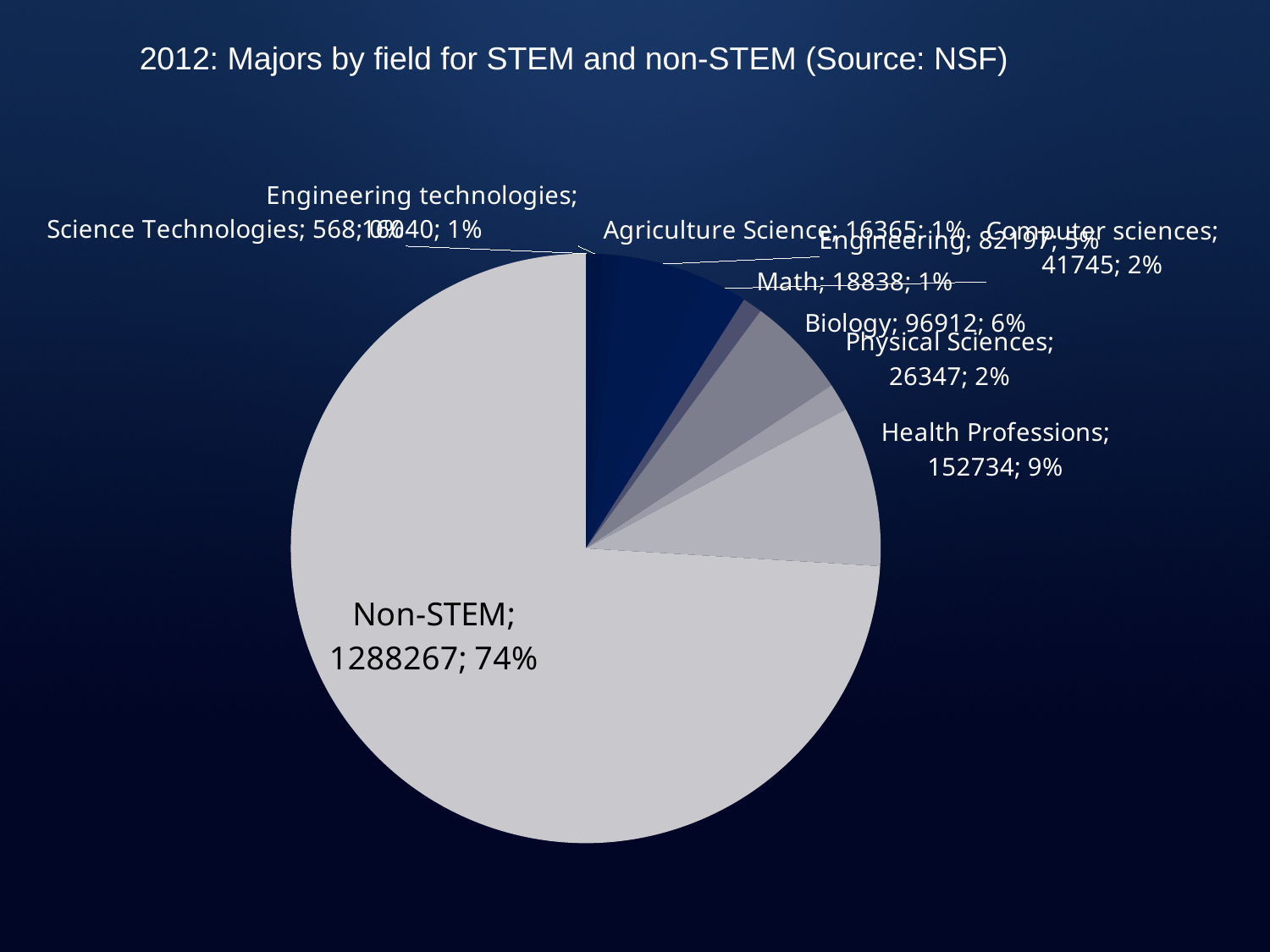
Which category has the largest slice of the pie? Non-STEM What is the value for Computer sciences? 41745 What is the difference between the values for Engineering and Computer sciences? 40452 What kind of chart is shown on the slide? pie chart Which is larger, Health Professions or Biology? Health Professions What share of the pie does Engineering represent? 5% What is the difference between the values for Health Professions and Biology? 55822 What is the value for Math? 18838 What is the value for Health Professions? 152734 What is the title of the chart? 2012: Majors by field for STEM and non-STEM (Source: NSF) What is the value for Biology? 96912 What share of the pie does Non-STEM represent? 74%